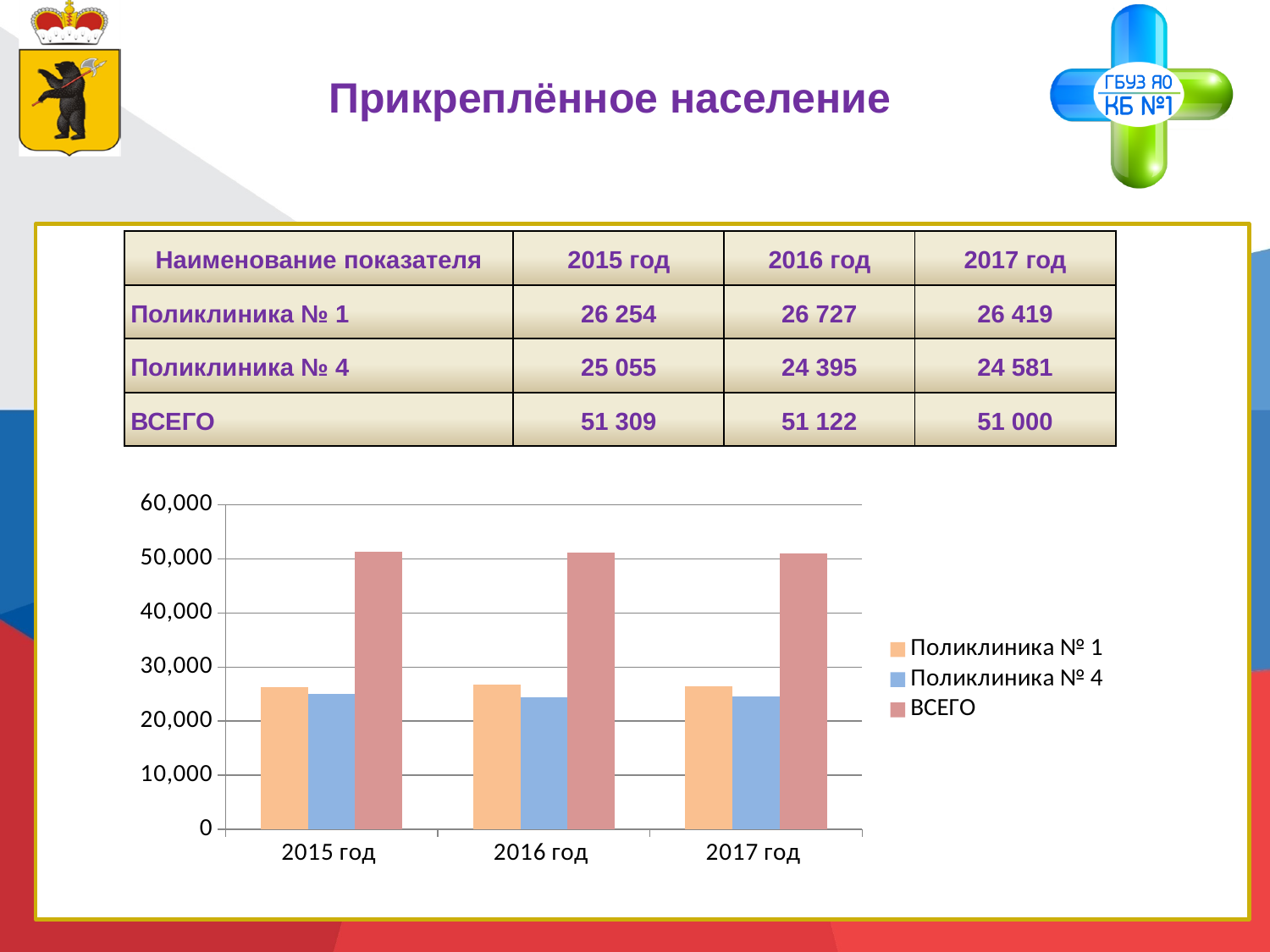
How many year categories are shown on the x axis of the chart? 3 Is the value for ВСЕГО in 2017 год greater or less than 50,000? greater How many series does the chart legend list? 3 What is the value for Поликлиника № 1 in 2016 год? 26 727 Is the value for Поликлиника № 4 in 2016 год greater or less than 30,000? less Which series has the highest bars in every year? ВСЕГО What is the value for Поликлиника № 4 in 2017 год? 24 581 What kind of chart is shown on the slide? bar chart What is the value for ВСЕГО in 2015 год? 51 309 What is the difference between Поликлиника № 1 and Поликлиника № 4 in 2015 год? 1 199 Does the value for ВСЕГО rise or fall from 2015 год to 2017 год? fall Which series has the lowest bars in every year? Поликлиника № 4